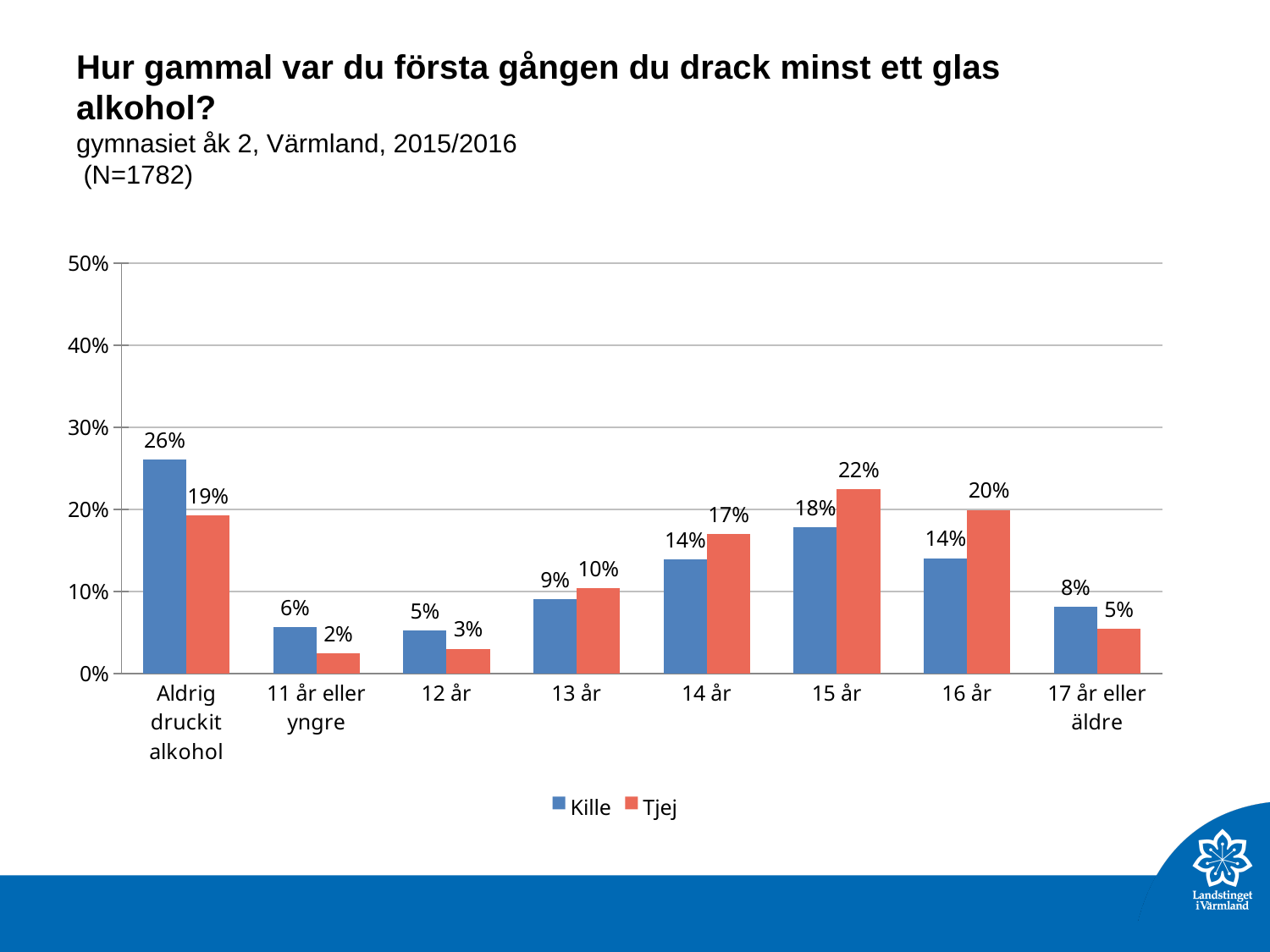
Which is larger at '17 år eller äldre', the Kille value or the Tjej value? Kille What is the value for Tjej at '15 år'? 22% How many series does the legend list? 2 What kind of chart is shown on the slide? Bar chart What is the value for Kille in the 'Aldrig druckit alkohol' category? 26% What are the two series named in the legend? Kille and Tjej How many categories are shown on the x axis? 8 Is the Tjej value at '16 år' greater or less than 10%? greater What is the value for Tjej in the '11 år eller yngre' category? 2% What is the difference between the Tjej and Kille values at '15 år'? 4% Which category has the highest value for Kille? Aldrig druckit alkohol Which category has the lowest value for Tjej? 11 år eller yngre